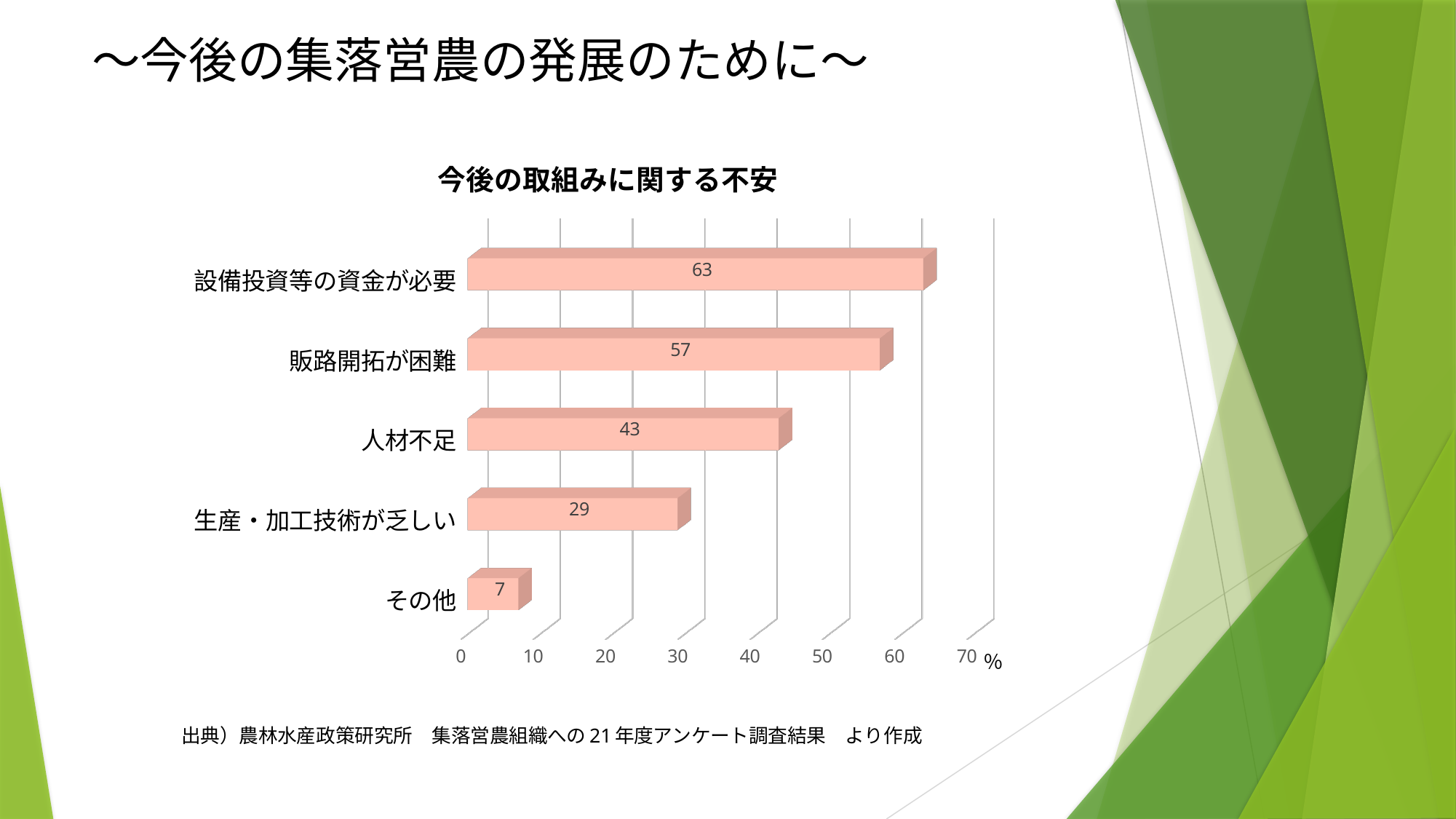
What is the difference between the values for 設備投資等の資金が必要 and 販路開拓が困難? 6 What is the value for その他? 7 What kind of chart is shown on the slide? bar chart What is the title of the chart? 今後の取組みに関する不安 Which category has the lowest value? その他 What is the value for 生産・加工技術が乏しい? 29 What is the value for 販路開拓が困難? 57 What is the value for 設備投資等の資金が必要? 63 What is the value for 人材不足? 43 Which category has the highest value? 設備投資等の資金が必要 How many categories are shown in the chart? 5 Which is larger, the value for 人材不足 or the value for 生産・加工技術が乏しい? 人材不足